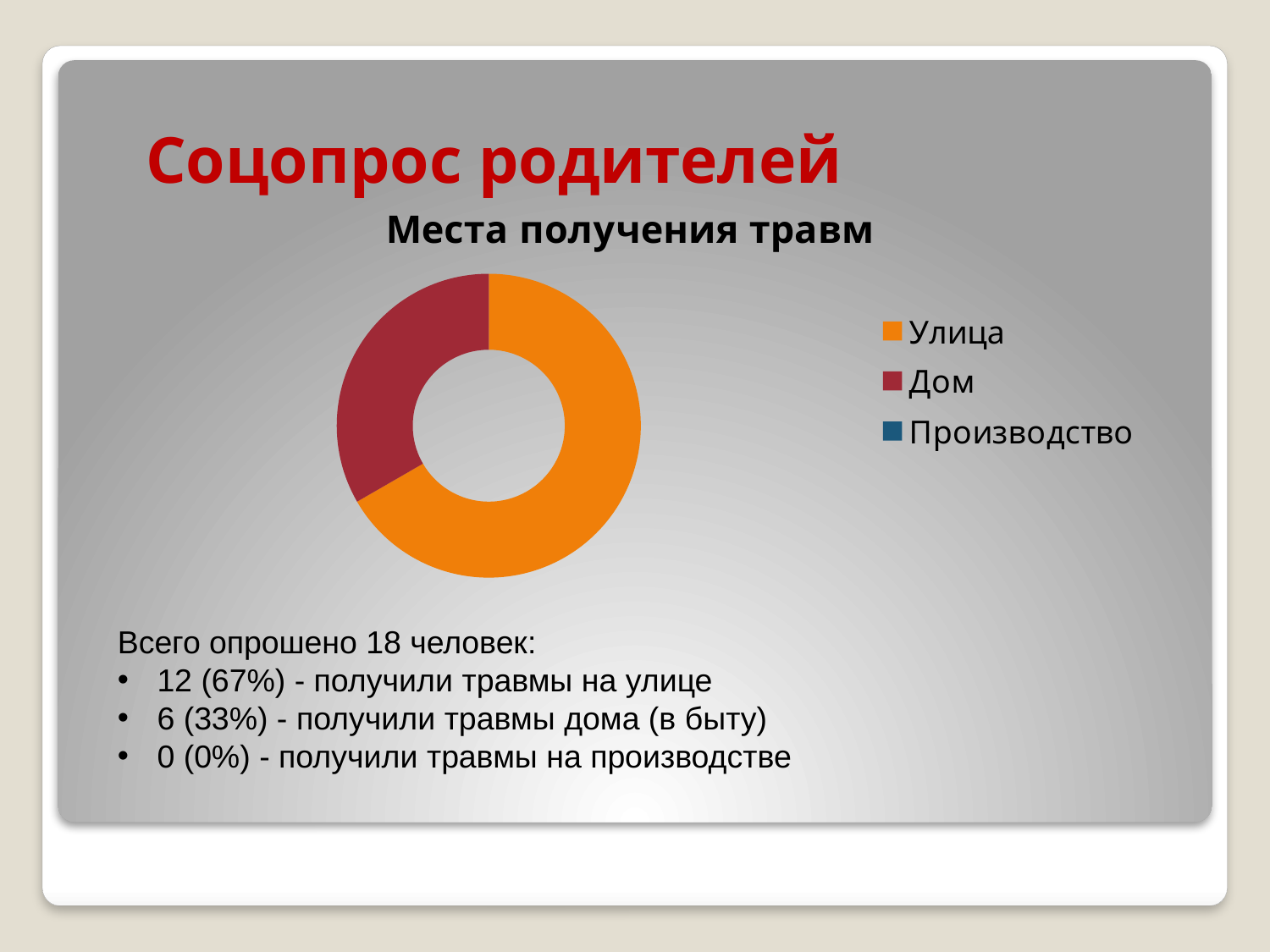
Which slice is larger, Улица or Дом? Улица How many respondents were injured on the street (Улица), according to the slide? 12 Which category has the smallest share in the chart? Производство How many entries does the chart legend list? 3 What is the title of the chart? Места получения травм What share of the chart does Улица account for, according to the slide? 67% What is the difference between the number of respondents injured on the street and at home? 6 Which colour represents Дом in the chart? Dark red Which category has the largest slice in the chart? Улица How many respondents were injured at home (Дом), according to the slide? 6 What share of the chart does Дом account for, according to the slide? 33% What kind of chart is shown on the slide? Doughnut chart